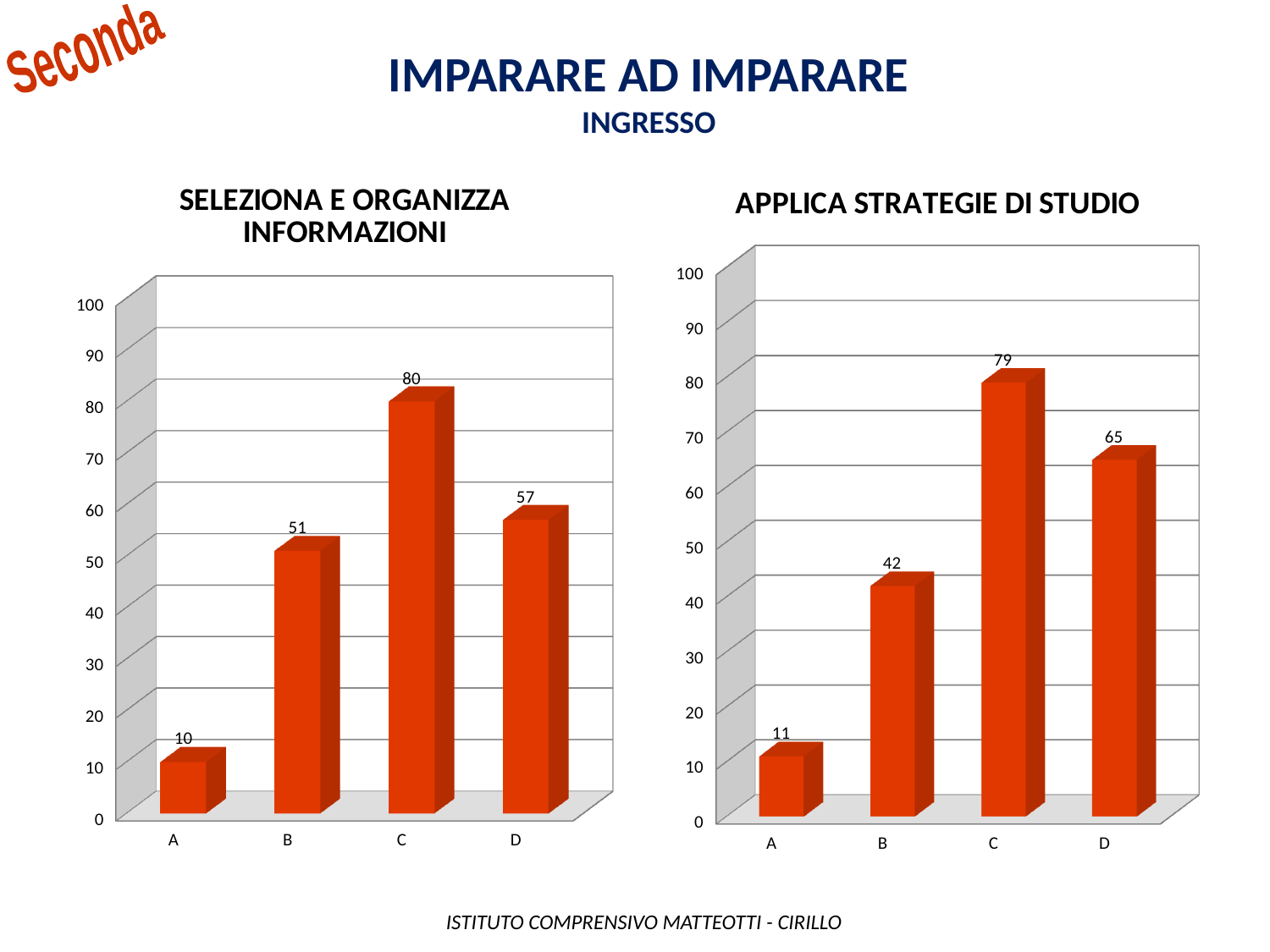
In the 'SELEZIONA E ORGANIZZA INFORMAZIONI' chart, which category has the lowest value? A In the 'SELEZIONA E ORGANIZZA INFORMAZIONI' chart, what is the value for category A? 10 In the 'APPLICA STRATEGIE DI STUDIO' chart, what is the difference between the values for D and A? 54 What is the title of the chart on the right side of the slide? APPLICA STRATEGIE DI STUDIO How many categories are shown in the 'SELEZIONA E ORGANIZZA INFORMAZIONI' chart? 4 In the 'APPLICA STRATEGIE DI STUDIO' chart, is the value for D greater or less than 60? greater In the 'APPLICA STRATEGIE DI STUDIO' chart, which category has the highest value? C In the 'SELEZIONA E ORGANIZZA INFORMAZIONI' chart, what is the difference between the values for C and D? 23 What kind of chart is the 'APPLICA STRATEGIE DI STUDIO' chart? Bar chart In the 'SELEZIONA E ORGANIZZA INFORMAZIONI' chart, what is the value for category C? 80 In the 'SELEZIONA E ORGANIZZA INFORMAZIONI' chart, which is larger, the value for B or the value for D? D In the 'APPLICA STRATEGIE DI STUDIO' chart, what is the value for category B? 42